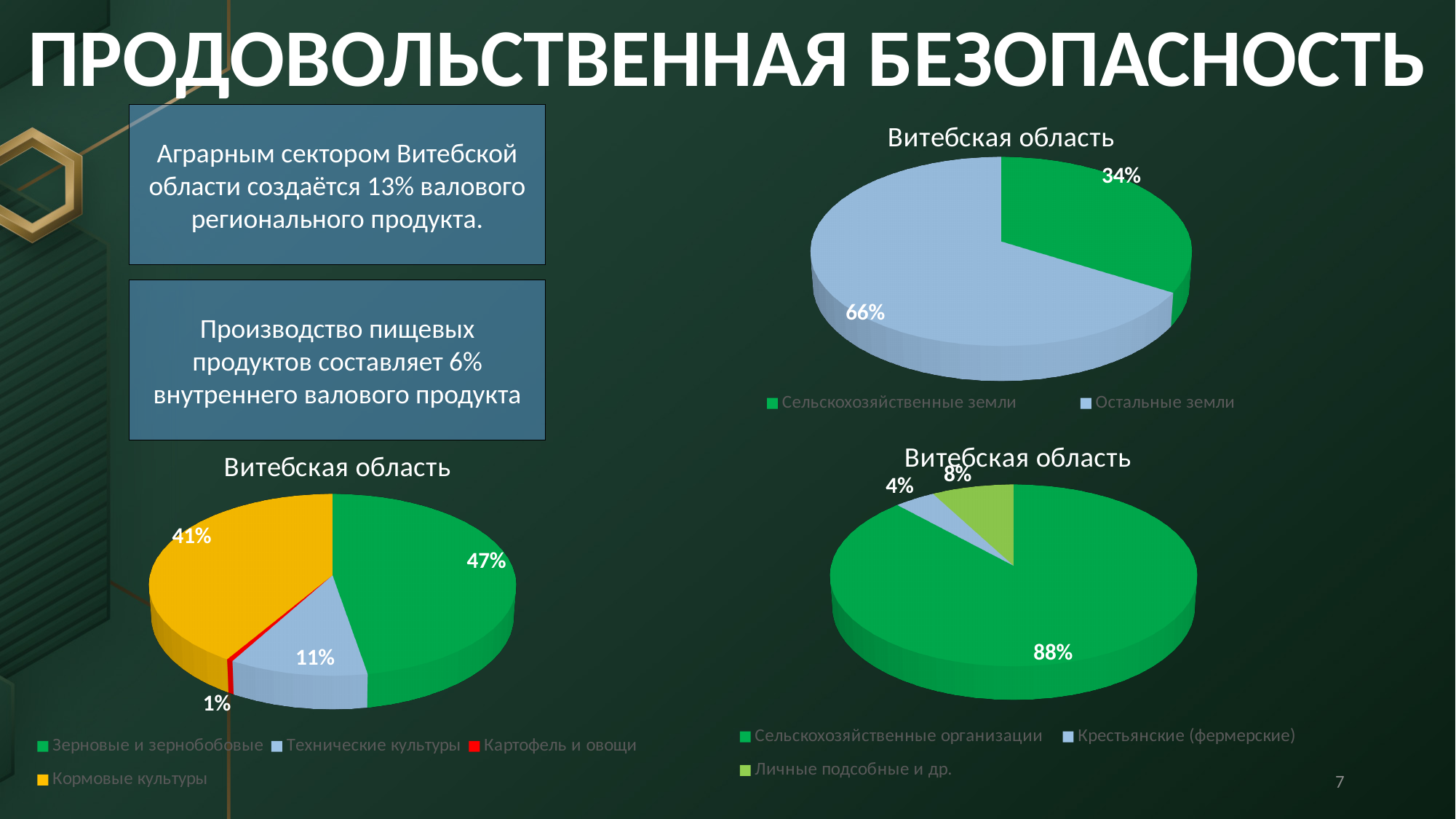
In the top-right pie chart, what share is labelled for Сельскохозяйственные земли? 34% In the top-right pie chart, what share is labelled for Остальные земли? 66% What type of chart is the top-right chart on the slide? Pie chart In the bottom-right pie chart, which category has the largest slice? Сельскохозяйственные организации In the top-right pie chart, which slice is larger: Сельскохозяйственные земли or Остальные земли? Остальные земли How many categories does the legend of the bottom-left pie chart list? 4 In the bottom-right pie chart, what share is labelled for Крестьянские (фермерские)? 4% In the bottom-left pie chart, what is the difference between the shares of Зерновые и зернобобовые and Технические культуры? 36% In the bottom-left pie chart, which category has the smallest slice? Картофель и овощи